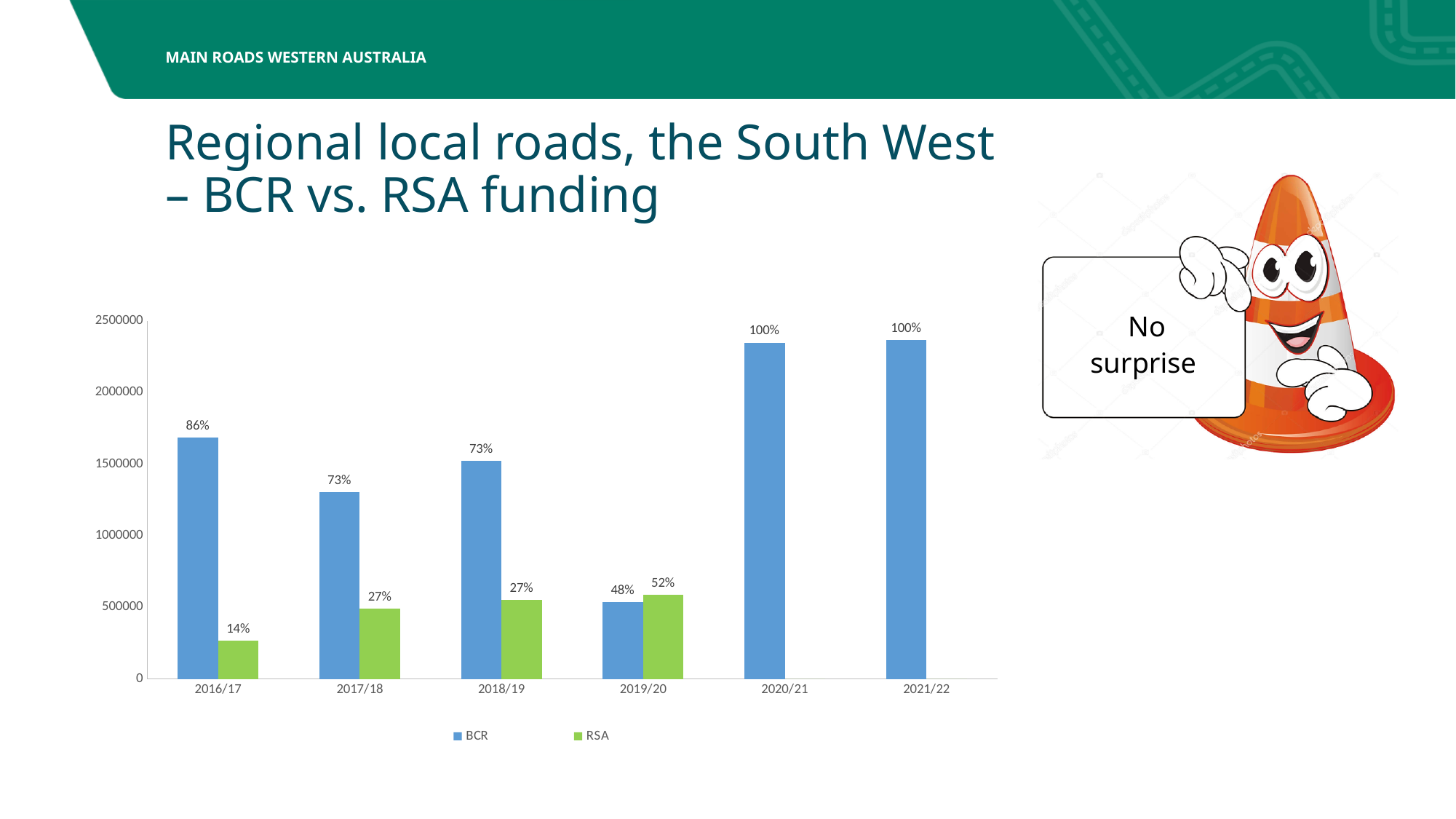
What percentage label is shown on the BCR bar for 2016/17? 86% Do the RSA bars rise or fall from 2016/17 to 2019/20? rise In 2019/20, which series has the taller bar, BCR or RSA? RSA How many financial years are shown on the x axis? 6 Which year has the tallest RSA bar? 2019/20 Is the BCR bar for 2016/17 greater or less than 1500000? greater What percentage label is shown on the RSA bar for 2019/20? 52% What percentage label is shown on the BCR bar for 2020/21? 100% What kind of chart is shown on the slide? bar chart How many series does the legend list? 2 Is the RSA bar for 2016/17 greater or less than 500000? less